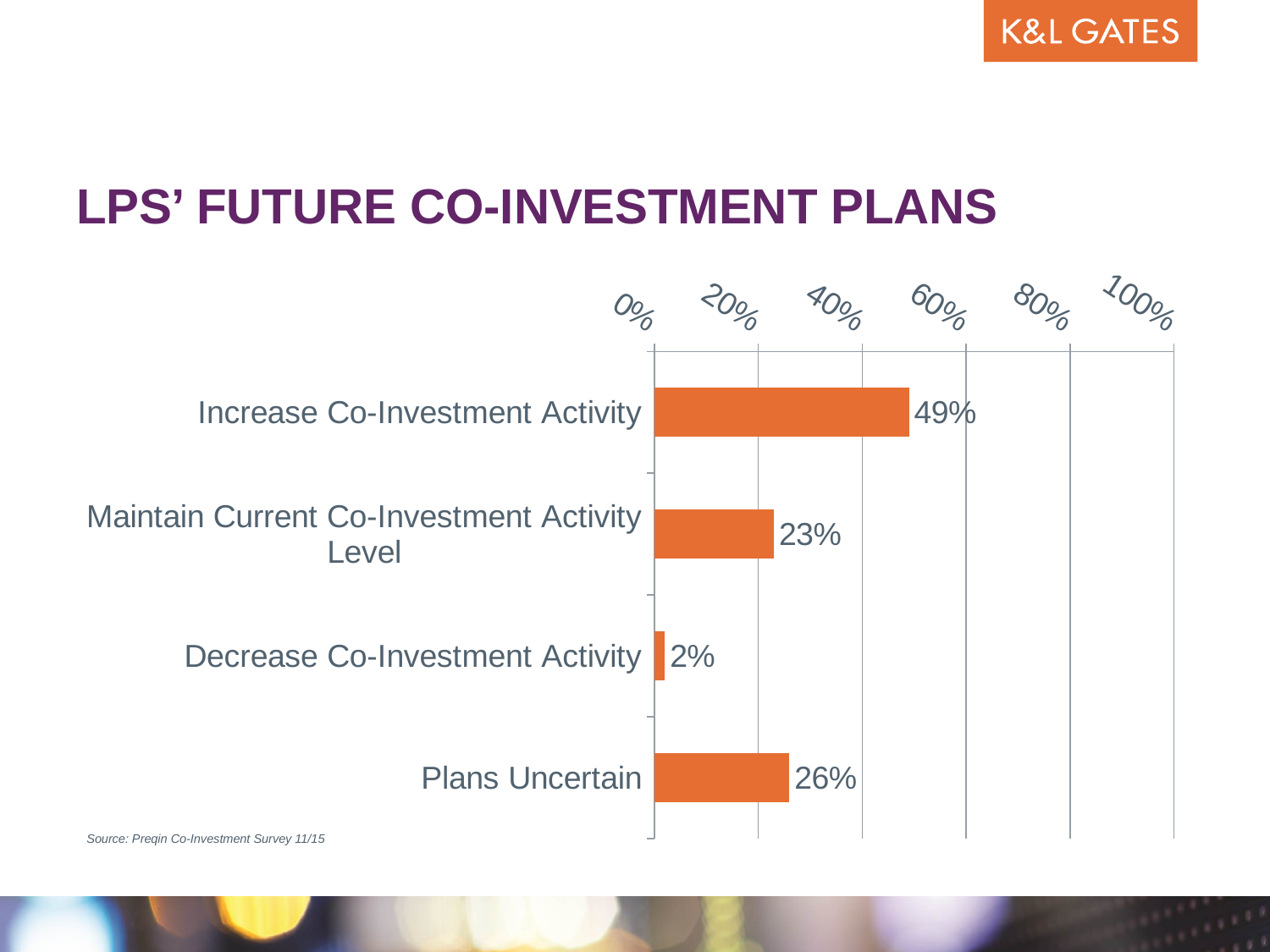
What is the value for Maintain Current Co-Investment Activity Level? 23% What is the value for Plans Uncertain? 26% What percentage of LPs plan to increase co-investment activity? 49% What is the difference between Increase Co-Investment Activity and Plans Uncertain? 23% Which is larger: Plans Uncertain or Maintain Current Co-Investment Activity Level? Plans Uncertain How many categories are shown in the chart? 4 What kind of chart is shown on the slide? Bar chart What is the value for Decrease Co-Investment Activity? 2% Which category has the lowest value? Decrease Co-Investment Activity Which category has the highest value? Increase Co-Investment Activity What is the title of the chart on the slide? LPS' FUTURE CO-INVESTMENT PLANS Is the value for Increase Co-Investment Activity greater or less than 60%? less